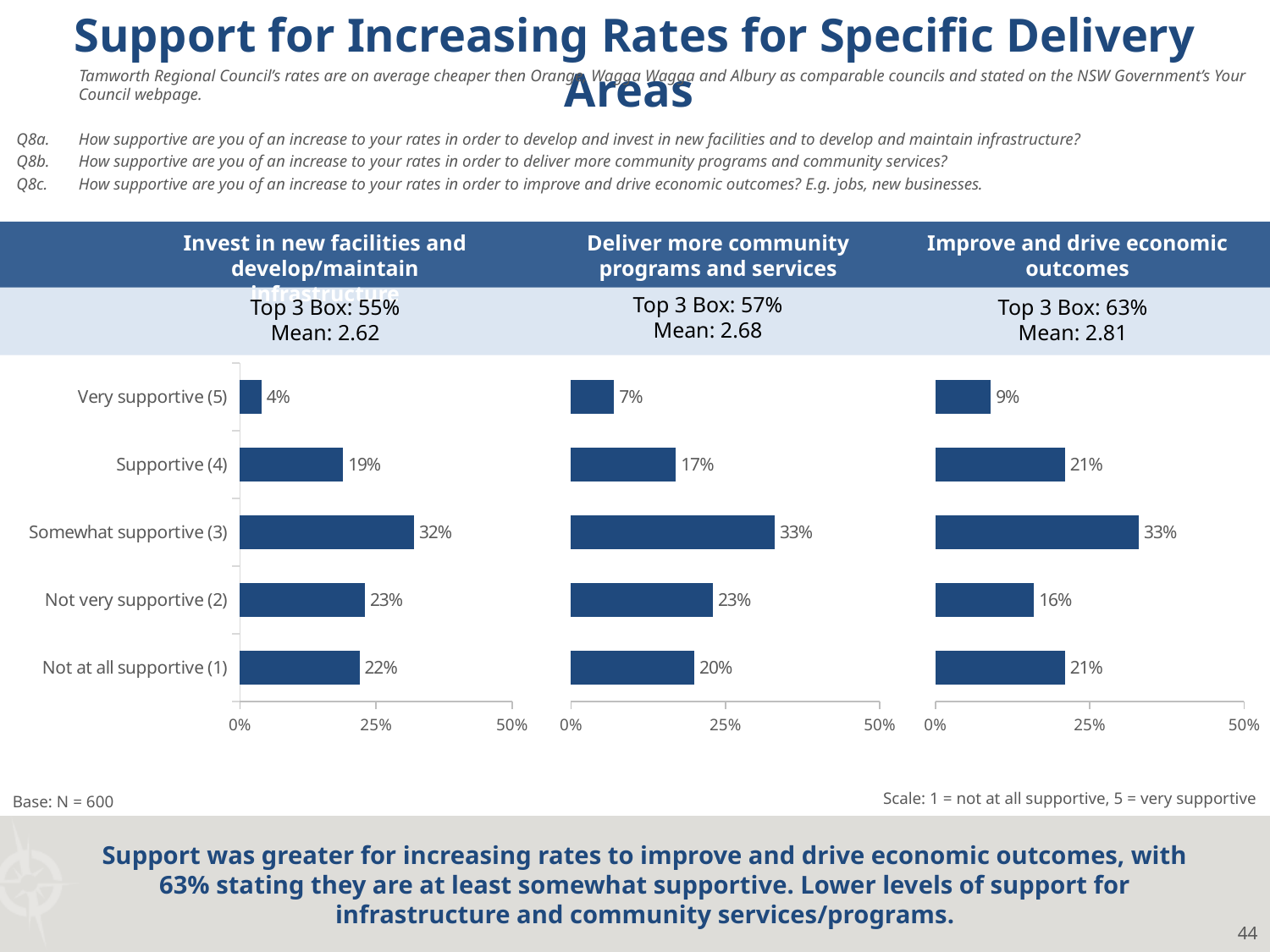
How many categories are shown in the 'Deliver more community programs and services' chart? 5 In the 'Deliver more community programs and services' chart, what percentage is shown for 'Not at all supportive (1)'? 20% In the 'Improve and drive economic outcomes' chart, which category has the highest value? Somewhat supportive (3) In the 'Deliver more community programs and services' chart, what is the difference between 'Somewhat supportive (3)' and 'Supportive (4)'? 16% In the 'Improve and drive economic outcomes' chart, what percentage is shown for 'Supportive (4)'? 21% In the 'Improve and drive economic outcomes' chart, which is larger: 'Not very supportive (2)' or 'Not at all supportive (1)'? Not at all supportive (1) What is the Mean shown for 'Deliver more community programs and services'? 2.68 What is the Top 3 Box percentage shown for 'Improve and drive economic outcomes'? 63% In the 'Invest in new facilities and develop/maintain infrastructure' chart, what percentage is shown for 'Very supportive (5)'? 4% In the 'Invest in new facilities and develop/maintain infrastructure' chart, which category has the lowest value? Very supportive (5) What type of chart is used for the 'Improve and drive economic outcomes' data? Bar chart In the 'Invest in new facilities and develop/maintain infrastructure' chart, is the value for 'Somewhat supportive (3)' greater or less than 25%? greater